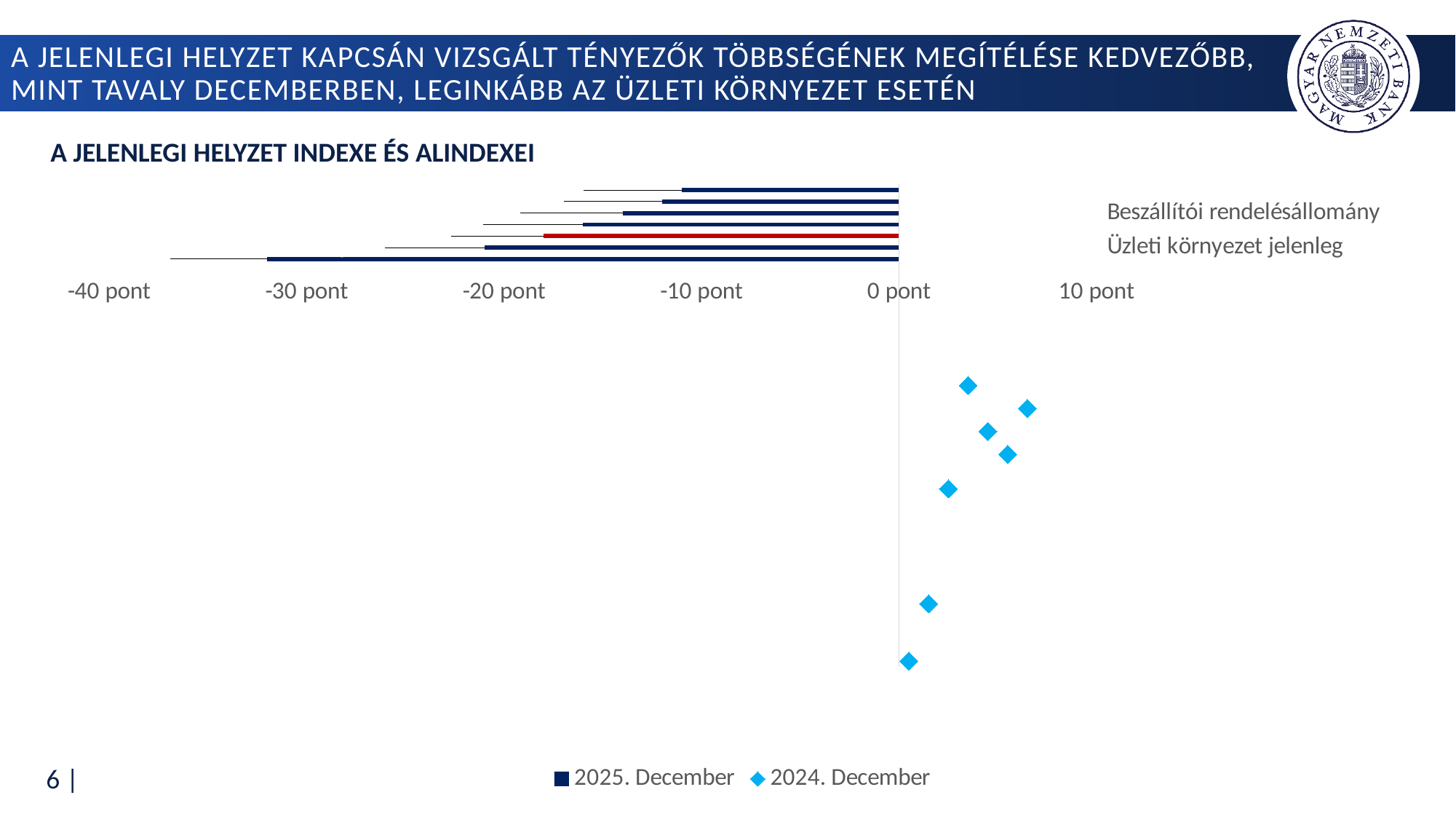
How many dark bars are plotted for the 2025. December series? 7 Which two series are listed in the chart legend? 2025. December and 2024. December Are the 2025. December bar values greater or less than 0 pont? less Are the 2024. December diamond values greater or less than 0 pont? greater How many diamond markers are plotted for the 2024. December series? 7 How many series does the chart legend list? 2 What is the lowest value shown on the horizontal axis? -40 pont Which series has the higher values overall, 2025. December or 2024. December? 2024. December Is the shortest 2025. December bar greater or less than -20 pont? greater What is the title of the chart? A JELENLEGI HELYZET INDEXE ÉS ALINDEXEI